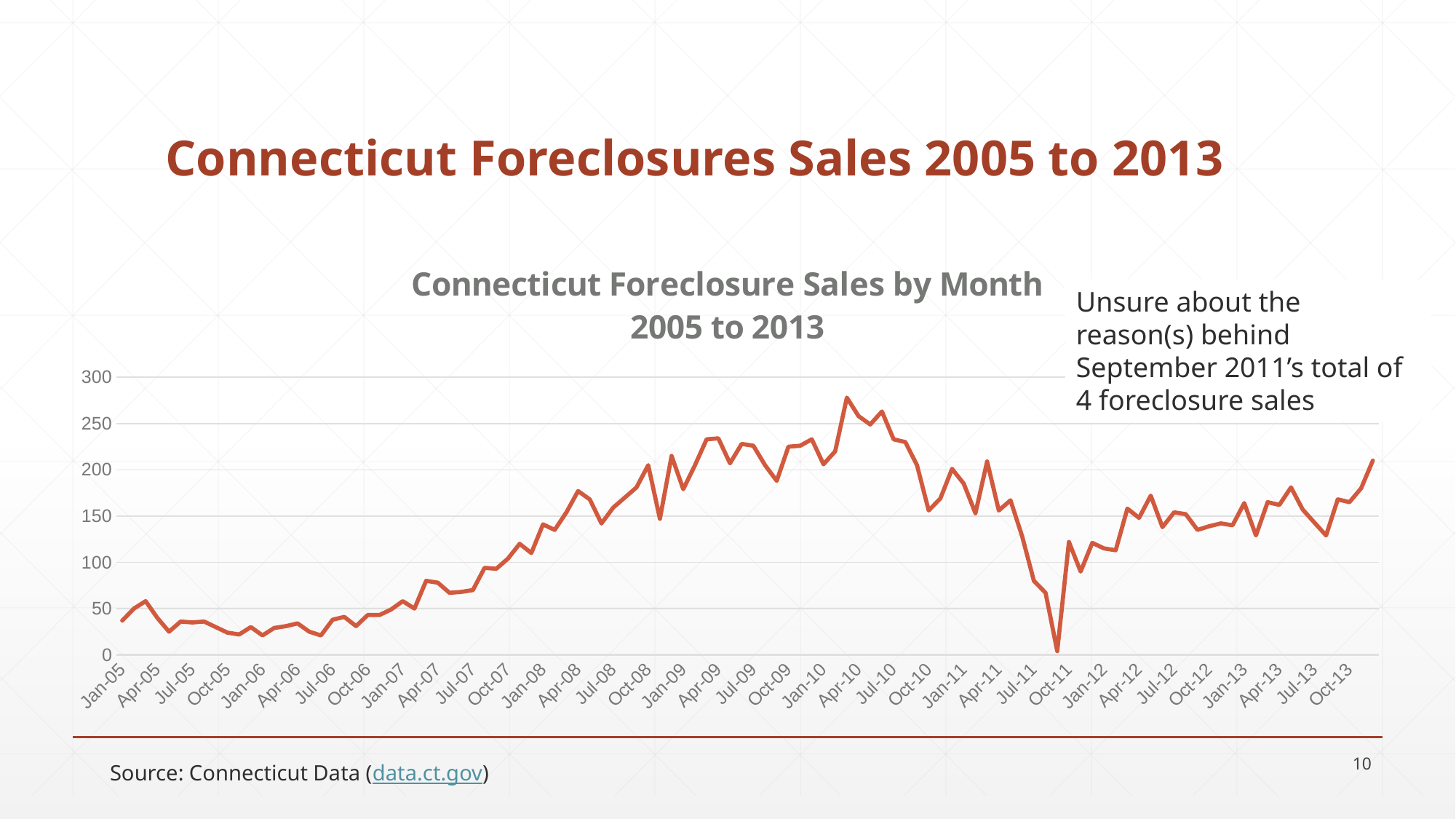
Is the value for Oct-13 greater or less than 150? greater Is the value for Jan-06 greater or less than 50? less What is the highest value shown on the vertical axis? 300 What kind of chart is shown on the slide? line chart Which month has the lowest number of foreclosure sales on the chart? September 2011 Which is larger, the value for Jan-05 or the value for Jan-10? Jan-10 Is the value for Jul-11 greater or less than 150? less How many foreclosure sales does the slide state for September 2011? 4 What is the title of the chart? Connecticut Foreclosure Sales by Month 2005 to 2013 Do foreclosure sales generally rise or fall from Jan-05 to Jan-10? rise